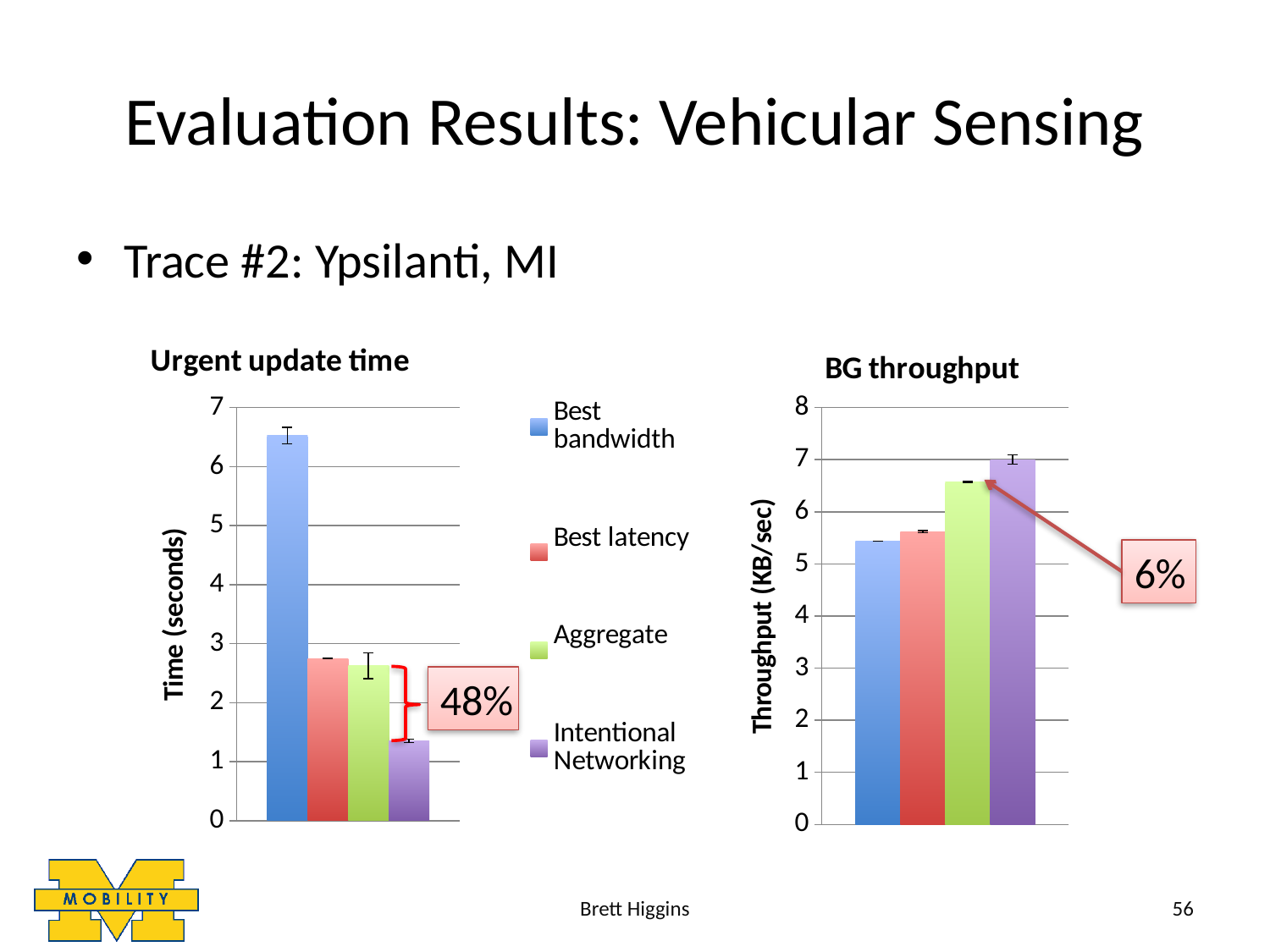
What kind of chart is the "Urgent update time" chart? bar chart In the "BG throughput" chart, is the value for Best bandwidth greater or less than 6? less In the "Urgent update time" chart, is the value for Intentional Networking greater or less than 2? less In the "Urgent update time" chart, which series has the highest value? Best bandwidth In the "BG throughput" chart, which is larger, the value for Aggregate or the value for Best latency? Aggregate In the "Urgent update time" chart, is the value for Best bandwidth greater or less than 6? greater In the "Urgent update time" chart, which series has the lowest value? Intentional Networking What percentage is shown in the callout next to the "Urgent update time" chart? 48% What is the y-axis label of the "BG throughput" chart? Throughput (KB/sec) How many series does the legend of the "Urgent update time" chart list? 4 In the "BG throughput" chart, which series has the highest value? Intentional Networking